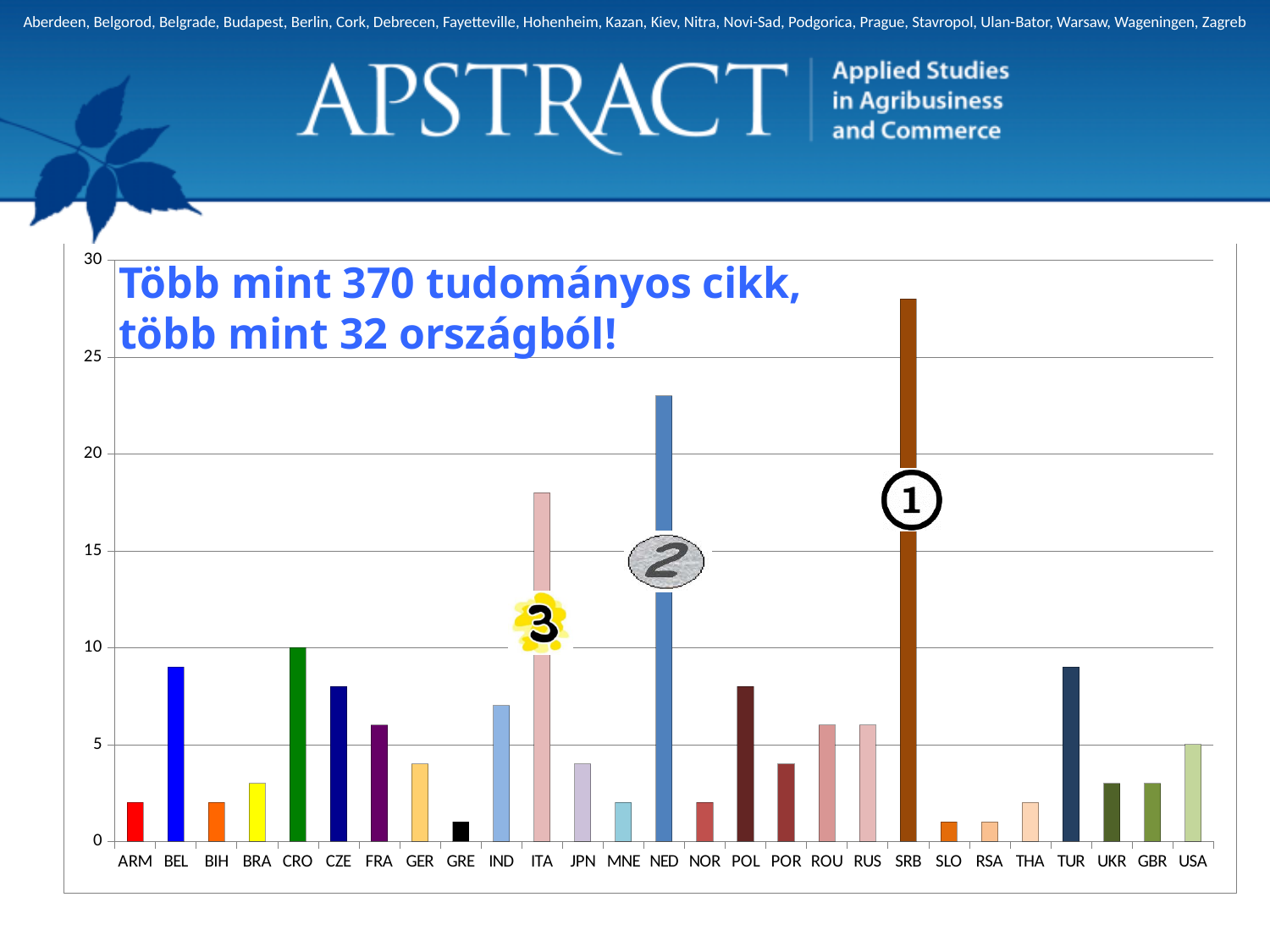
Is the value for GER greater or less than 5? less Which country has the highest bar in the chart? SRB Is the value for NED greater or less than 20? greater Which has the larger value, NED or ITA? NED Which country's bar is marked with the number 1 in the chart? SRB What is the value for CRO in the chart? 10 Which has the larger value, TUR or UKR? TUR Is the value for ITA greater or less than 15? greater What kind of chart is shown on the slide? bar chart What is the value for USA in the chart? 5 How many countries are shown on the x axis of the chart? 27